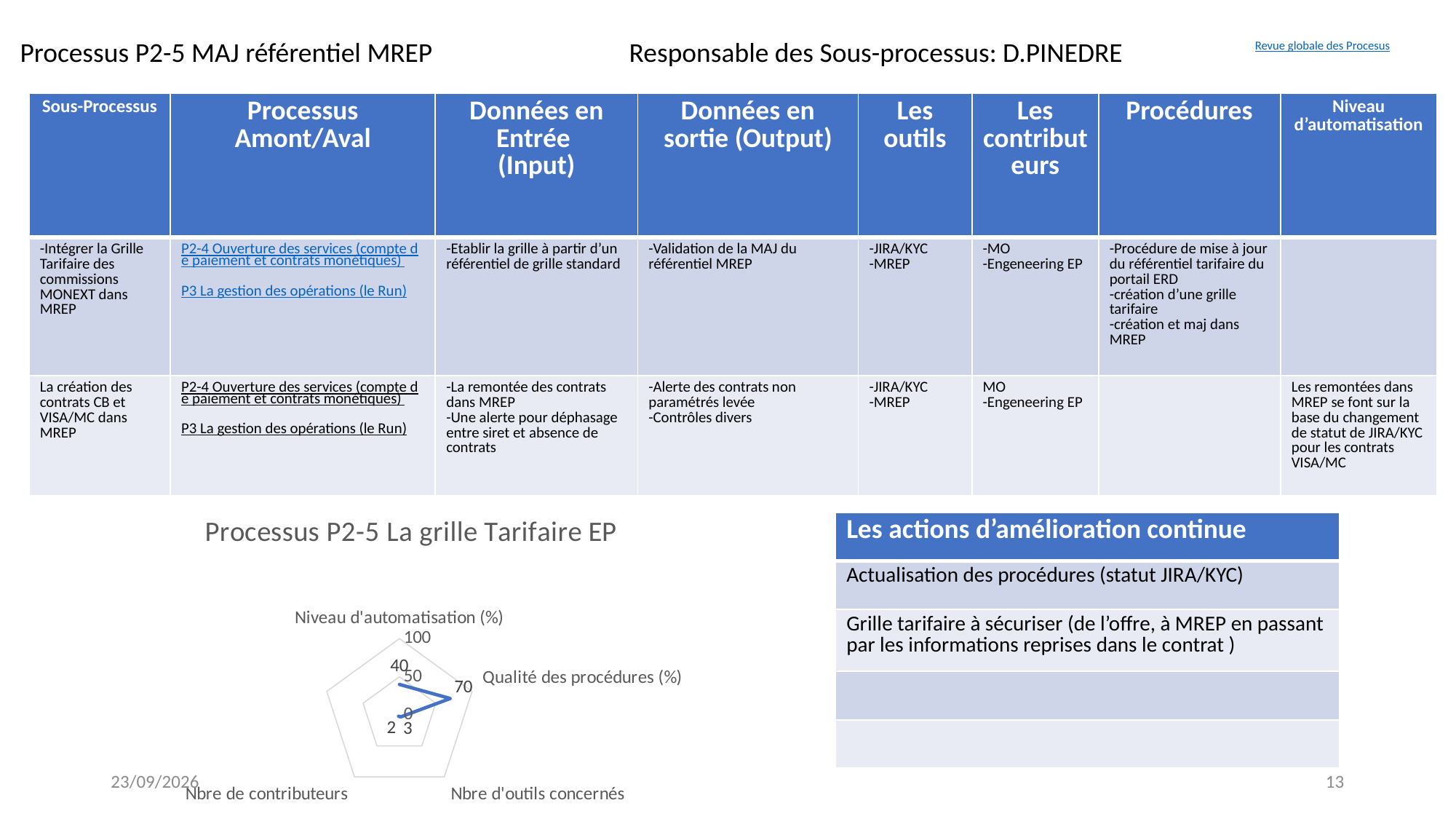
What is the value for Qualité des procédures (%) in the radar chart? 70 What kind of chart is shown on the slide? radar chart What is the difference between the value for Qualité des procédures (%) and the value for Nbre d'outils concernés? 67 What is the difference between the value for Nbre d'outils concernés and the value for Nbre de contributeurs? 1 Which axis has the highest plotted value in the radar chart? Qualité des procédures (%) How many axes does the radar chart have? 5 What is the value for Nbre de contributeurs in the radar chart? 2 Which is larger in the radar chart, the value for Qualité des procédures (%) or the value for Nbre d'outils concernés? Qualité des procédures (%) Is the value for Qualité des procédures (%) greater or less than 100? less What is the maximum tick value shown on the Niveau d'automatisation (%) axis of the radar chart? 100 What is the title of the chart on the slide? Processus P2-5 La grille Tarifaire EP What is the value for Nbre d'outils concernés in the radar chart? 3